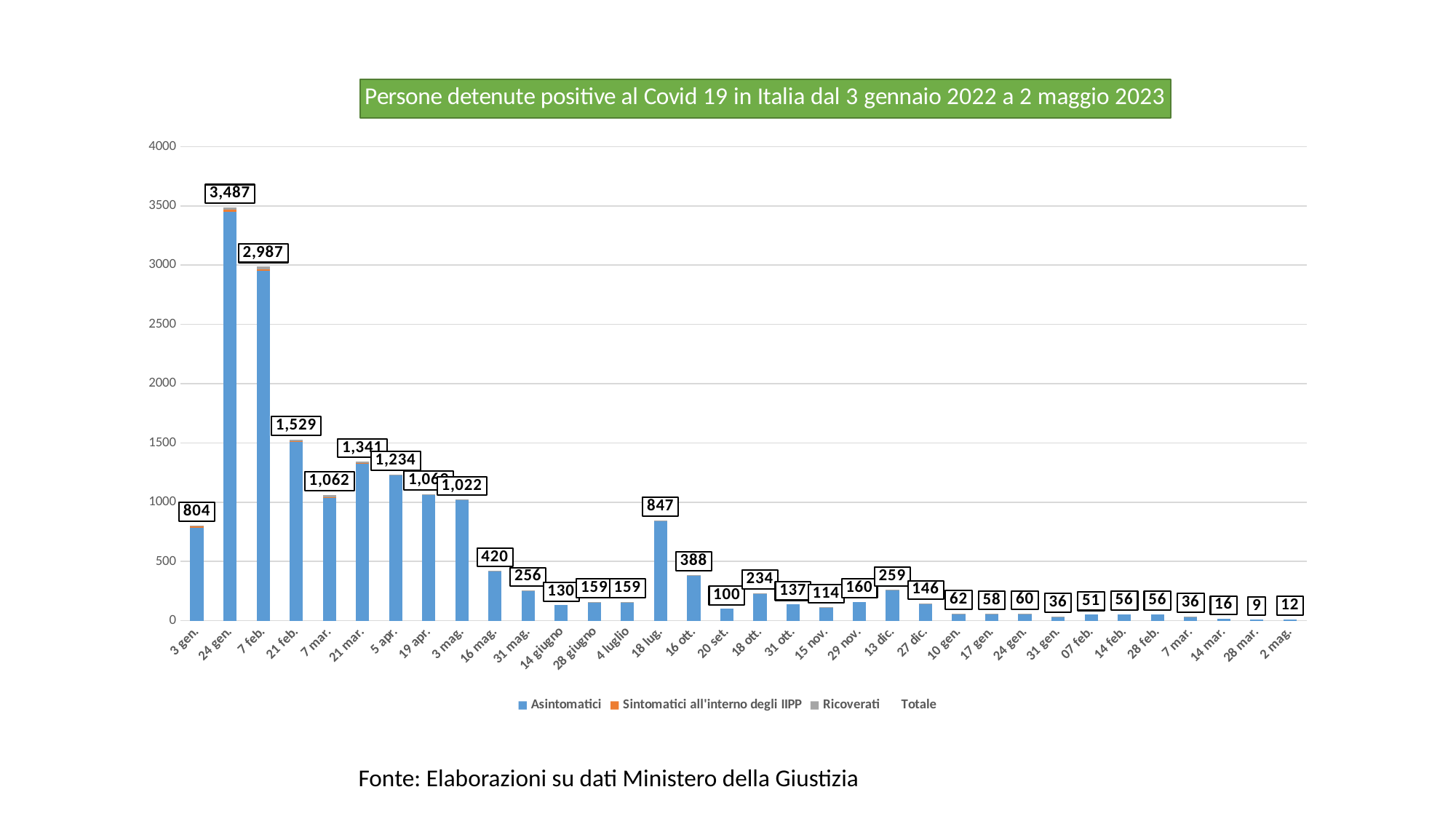
Is the value for 7 feb. greater or less than 2500? greater Which date has the highest total? 24 gen. (the second bar) What is the total value labelled for 16 ott.? 388 Which date has the lowest total? 28 mar. How many series does the legend list? 4 Which has a larger total, 21 mar. or 5 apr.? 21 mar. What is the total value labelled for 3 gen., the first bar? 804 What is the total value labelled for 18 lug.? 847 What is the total value labelled for 13 dic.? 259 Overall, do the totals rise or fall from left to right along the x axis? fall What is the difference between the totals for the second bar (24 gen.) and 7 feb.? 500 What kind of chart is shown on the slide? bar chart